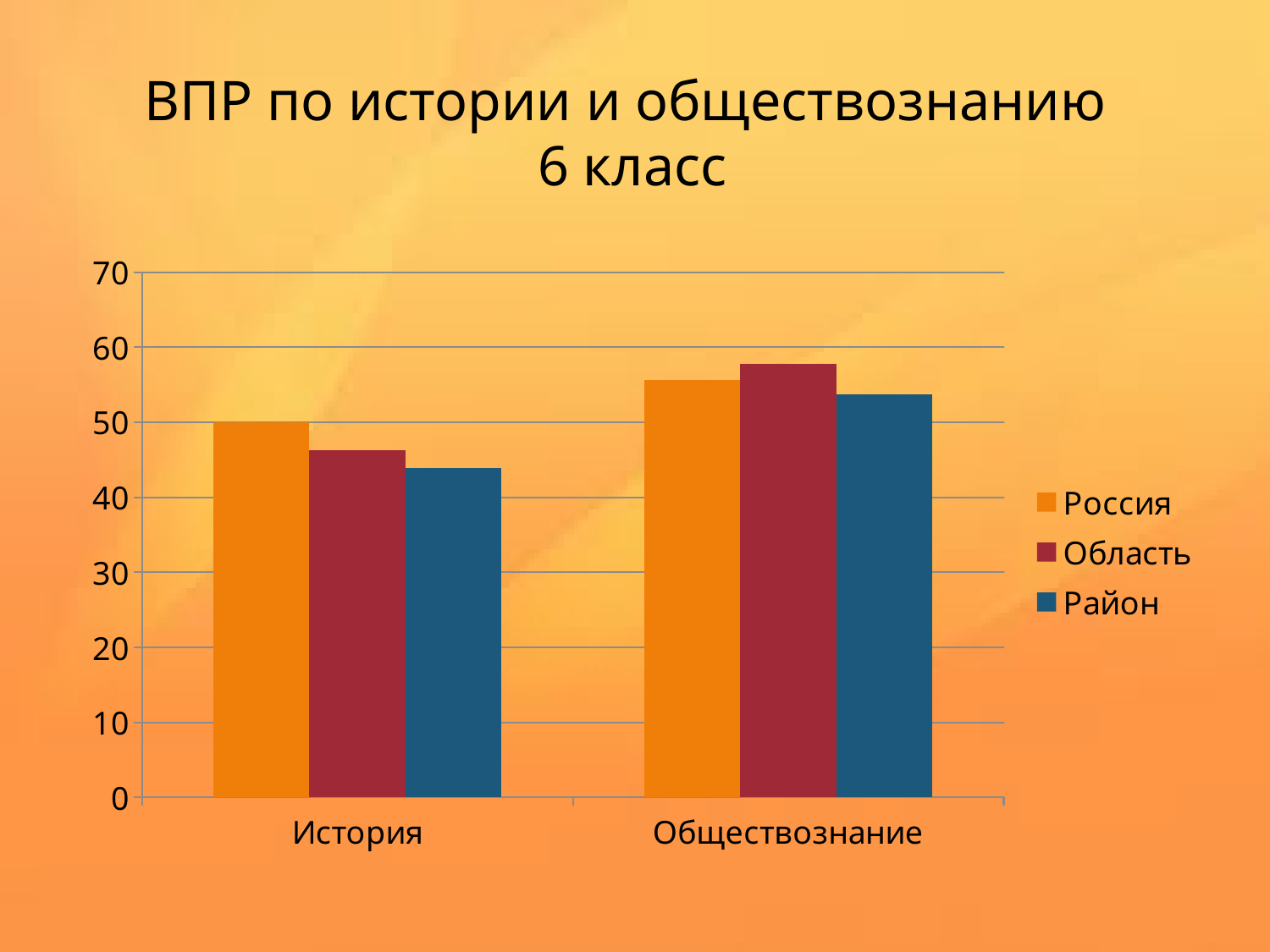
Is the value for Район in История greater or less than 50? less Which is larger: the value for Россия in История or the value for Россия in Обществознание? Россия in Обществознание What is the title of the slide? ВПР по истории и обществознанию 6 класс Do the values for Район rise or fall from История to Обществознание? rise How many categories are shown on the x axis? 2 Is the value for Область in История greater or less than 50? less Which series has the highest value for История? Россия Is the value for Область in Обществознание greater or less than 60? less How many series does the legend list? 3 What kind of chart is shown on the slide? bar chart